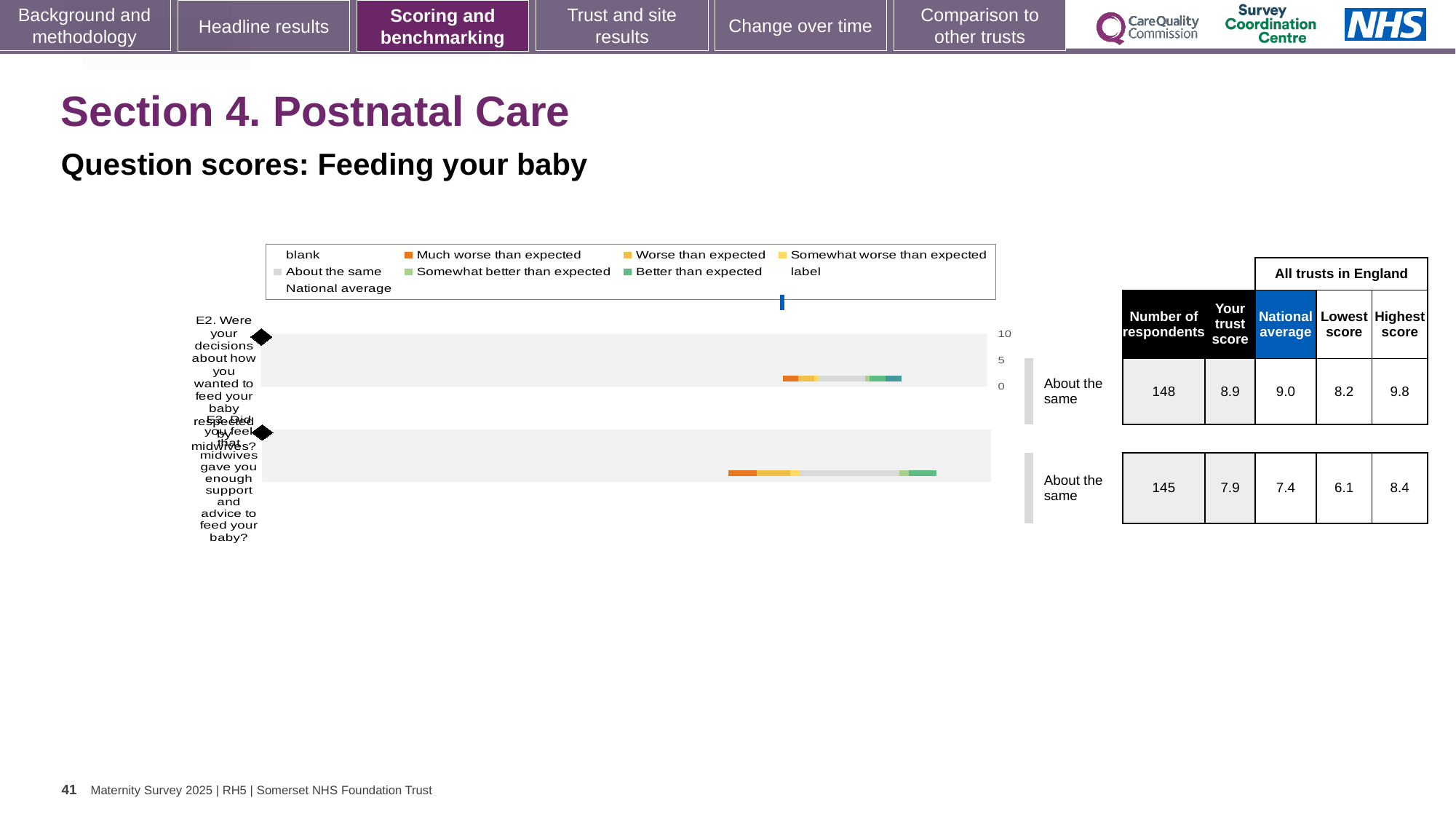
How many respondents answered question E2? 148 What is the lowest score among all trusts in England for question E3? 6.1 What is the national average for question E3 (midwives gave you enough support and advice to feed your baby)? 7.4 What is the trust score for question E2 (decisions about how you wanted to feed your baby respected by midwives)? 8.9 What kind of chart is used to show the question scores on this slide? bar chart By how much does the trust score for question E3 exceed the national average for E3? 0.5 Which question has the higher national average? E2 What is the difference between the highest score and the lowest score for question E2? 1.6 How many questions (categories) are plotted in the chart? 2 What benchmark category is shown for question E2? About the same Which question has the higher trust score, E2 or E3? E2 What is the subtitle of the chart on this slide? Question scores: Feeding your baby